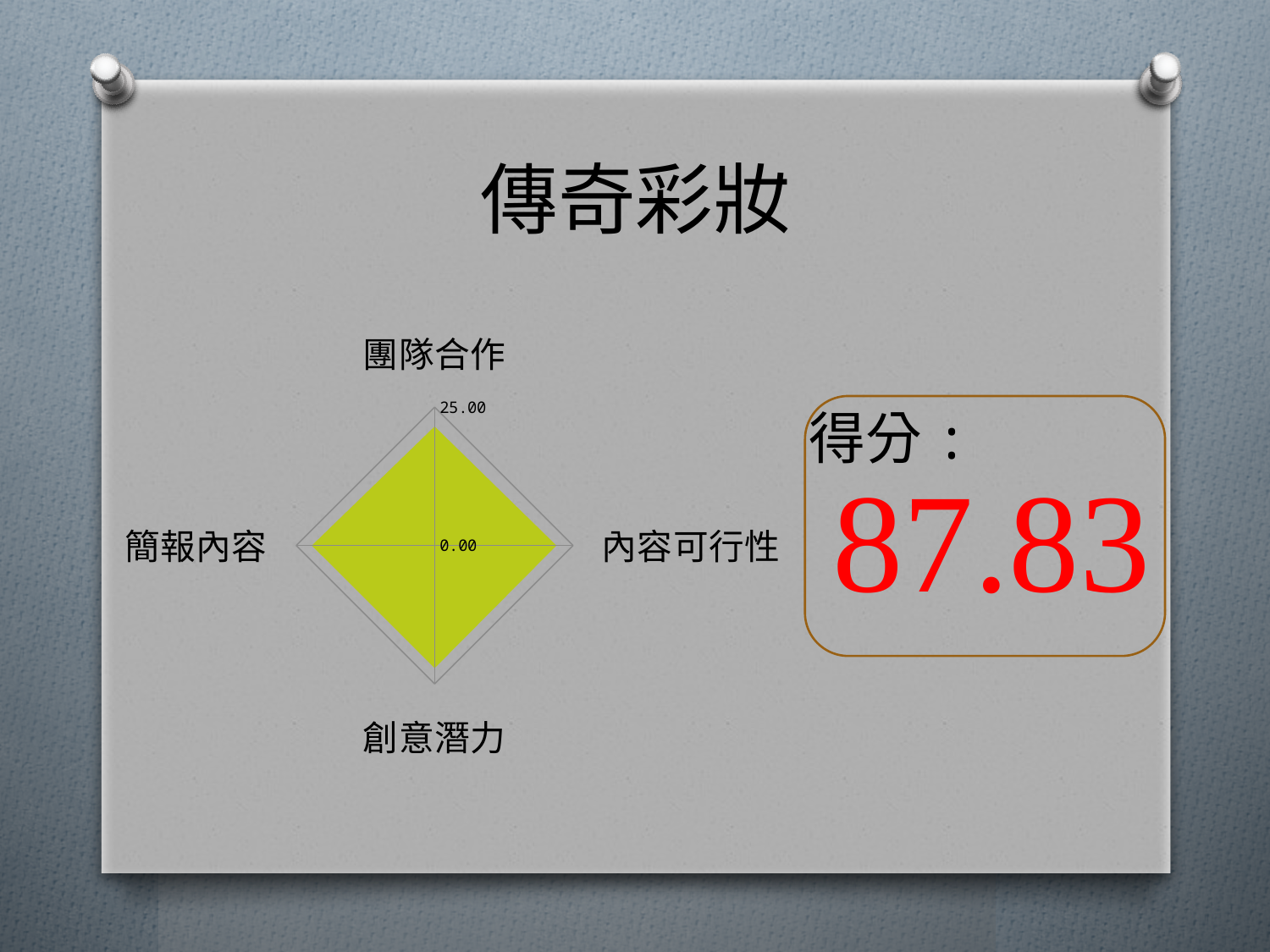
What is the maximum value shown on the radar chart's axis scale? 25.00 Is the value for 創意潛力 greater or less than 0.00? greater What kind of chart is shown on the slide? radar chart Which category label appears at the bottom of the radar chart? 創意潛力 What is the minimum value shown on the radar chart's axis scale? 0.00 Which category label appears on the right side of the radar chart? 內容可行性 Is the value for 團隊合作 greater or less than 25.00? less Which category label appears at the top of the radar chart? 團隊合作 How many categories (axes) does the radar chart have? 4 Which category label appears on the left side of the radar chart? 簡報內容